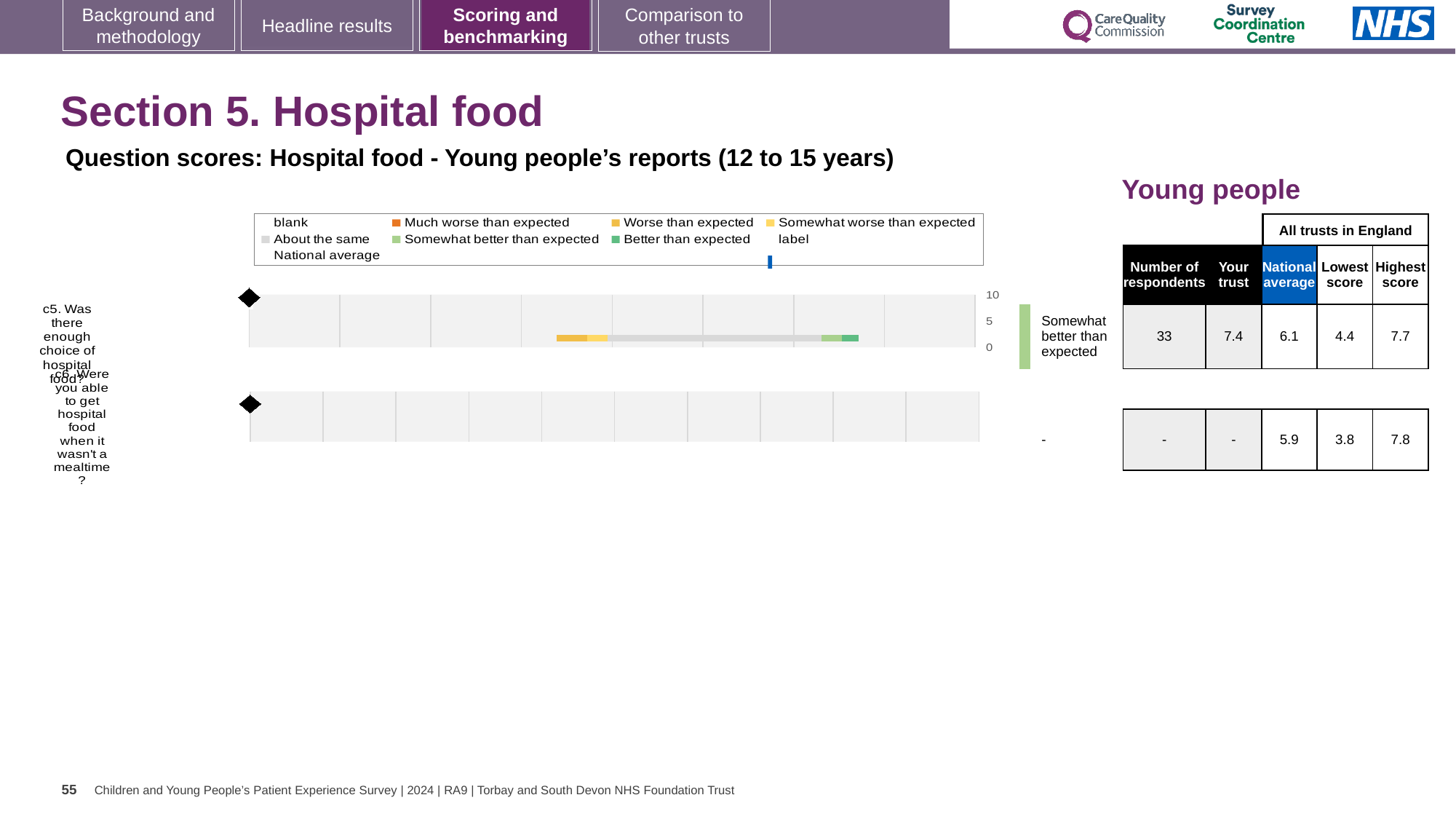
How many respondents answered question c5? 33 What is the lowest score among all trusts in England for question c6? 3.8 How is the trust's result for question c5 categorised relative to expectation? Somewhat better than expected What is the 'Your trust' score for question c5 (Was there enough choice of hospital food?)? 7.4 What is the national average score for question c6? 5.9 What is the difference between the highest and lowest scores for question c5? 3.3 What is the national average score for question c5? 6.1 What kind of chart is used to show the question scores for hospital food? bar chart For question c5, which is larger: the trust's score or the national average? Your trust What is the highest score among all trusts in England for question c6 (Were you able to get hospital food when it wasn't a mealtime?)? 7.8 How many questions (categories) are plotted on the chart? 2 What is the maximum value shown on the chart's score axis? 10